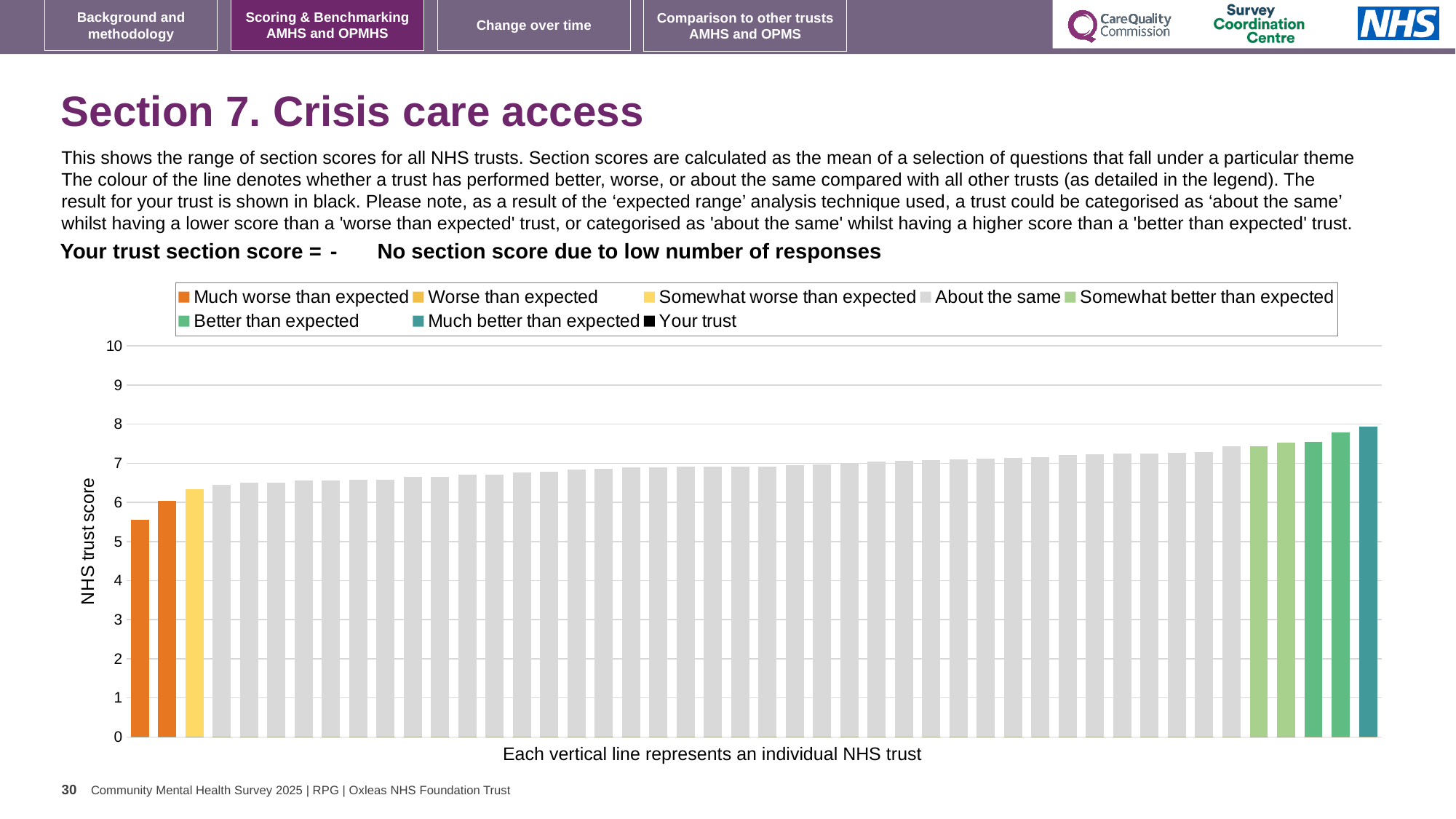
What is the highest value shown on the y axis? 10 Is the value of the lowest (leftmost) bar greater or less than 6? less Do the bar values rise or fall from left to right along the x axis? rise Is the value of the highest (rightmost) bar greater or less than 7? greater How many bars are coloured teal ('Much better than expected')? 1 Is the value of the yellow 'Somewhat worse than expected' bar greater or less than 6? greater How many bars are coloured orange ('Much worse than expected')? 2 How many entries does the chart legend list? 8 What is the label of the y axis? NHS trust score Which colour category has the most bars in the chart? About the same What kind of chart is shown on the slide? bar chart